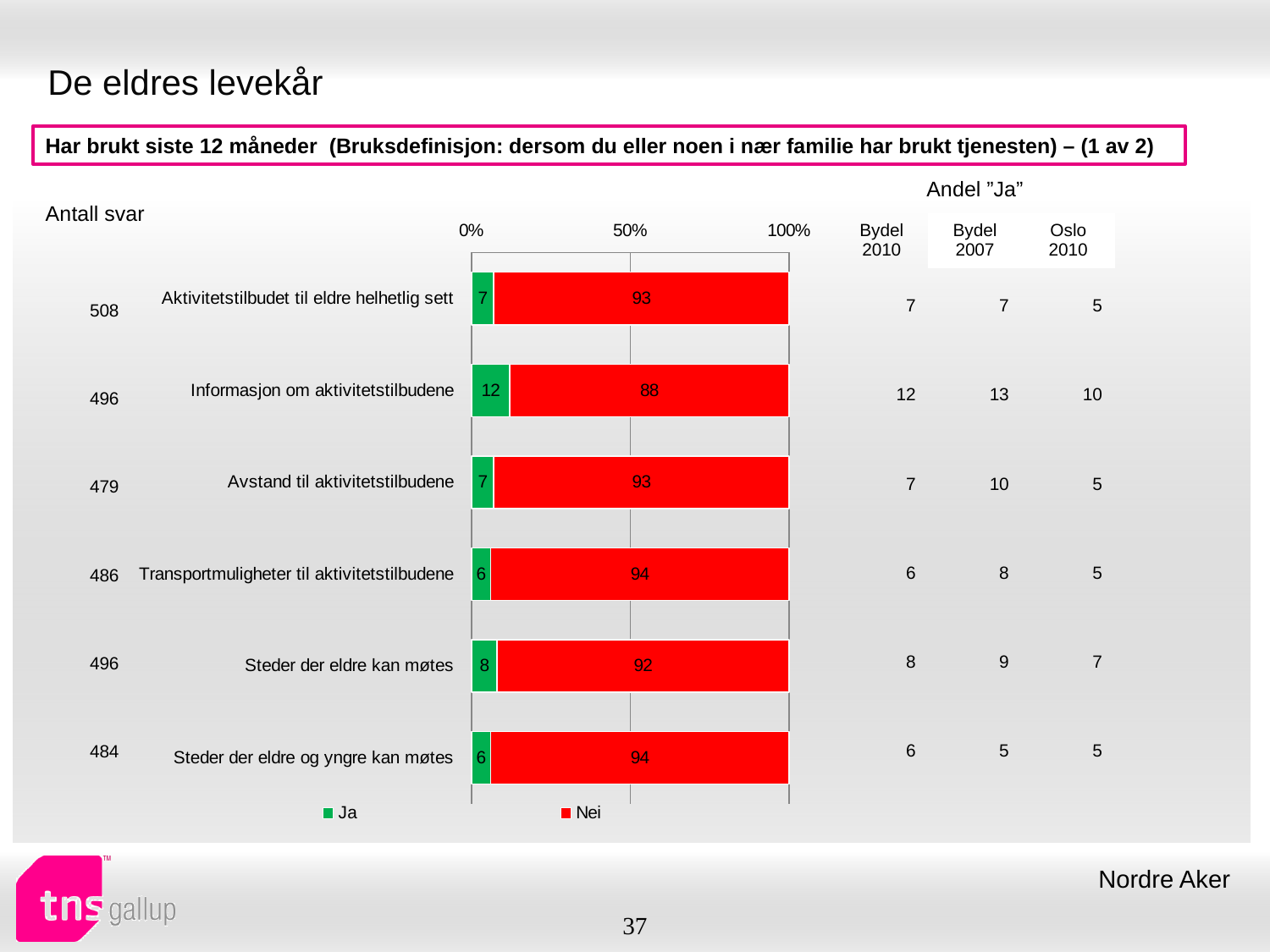
What kind of chart is shown on the slide? bar chart What is the "Ja" value for "Transportmuligheter til aktivitetstilbudene"? 6 Which category has the lowest "Nei" value? Informasjon om aktivitetstilbudene What is the "Nei" value for "Steder der eldre kan møtes"? 92 How many categories are plotted in the chart? 6 What are the two legend entries of the chart? Ja and Nei Which is larger, the "Ja" value for "Steder der eldre kan møtes" or the "Ja" value for "Avstand til aktivitetstilbudene"? Steder der eldre kan møtes Which category has the highest "Ja" value? Informasjon om aktivitetstilbudene How many series does the chart legend list? 2 What is the difference between the "Nei" and "Ja" values for "Informasjon om aktivitetstilbudene"? 76 Is the "Nei" value for "Aktivitetstilbudet til eldre helhetlig sett" greater or less than 50%? greater What is the "Ja" value for "Informasjon om aktivitetstilbudene"? 12